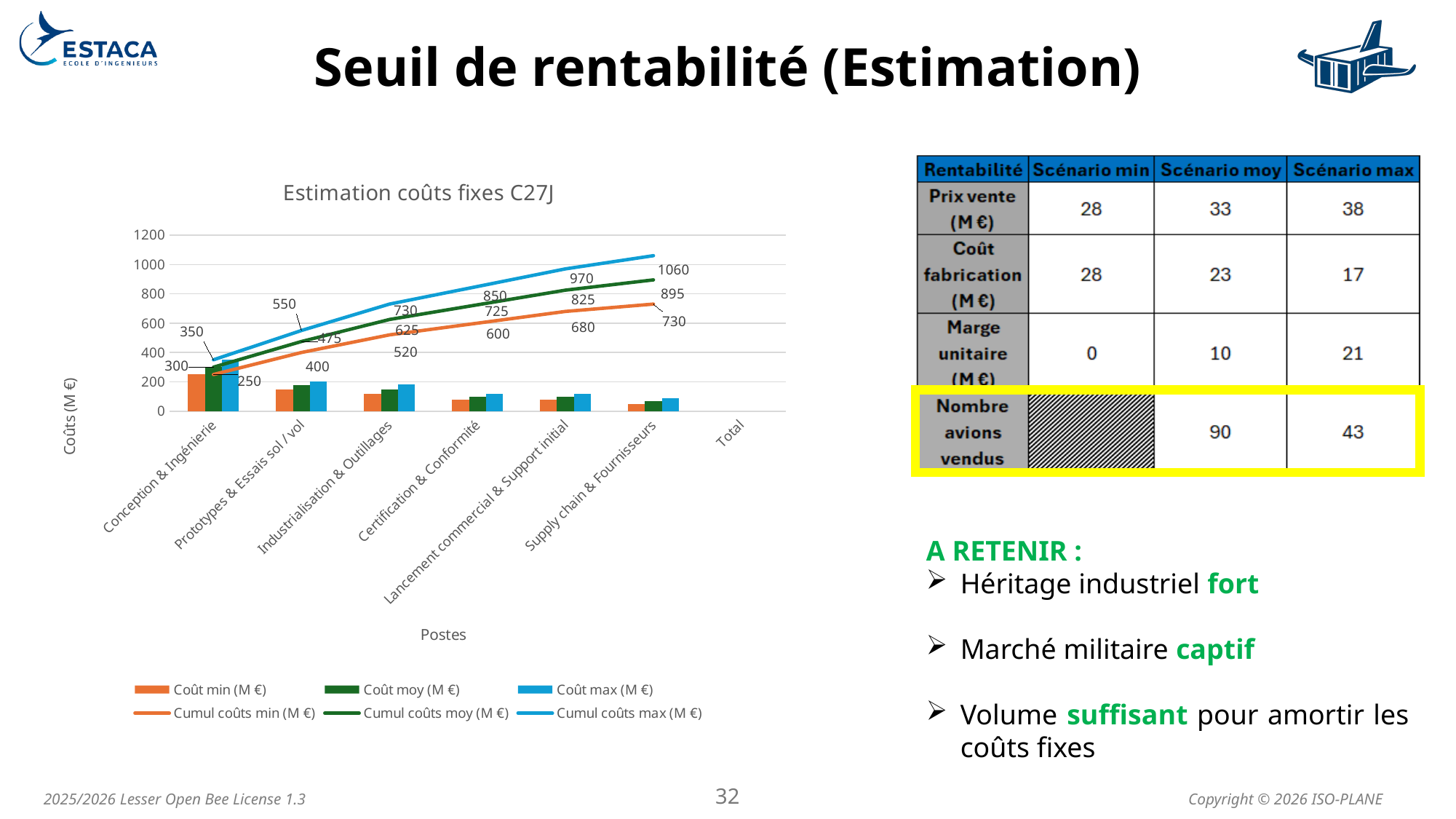
In the chart 'Estimation coûts fixes C27J', is the Coût max (M €) bar for Conception & Ingénierie greater or less than 200? greater In the chart 'Estimation coûts fixes C27J', does the Cumul coûts max (M €) line rise or fall from Conception & Ingénierie to Supply chain & Fournisseurs? rise In the chart 'Estimation coûts fixes C27J', at which category does the Cumul coûts moy (M €) line reach its highest labelled value? Supply chain & Fournisseurs In the chart 'Estimation coûts fixes C27J', what is the value of Cumul coûts min (M €) at Certification & Conformité? 600 In the chart 'Estimation coûts fixes C27J', what is the value of Cumul coûts moy (M €) at Prototypes & Essais sol / vol? 475 How many categories are shown on the x axis of the chart 'Estimation coûts fixes C27J'? 7 In the chart 'Estimation coûts fixes C27J', is the Coût min (M €) bar for Supply chain & Fournisseurs greater or less than 100? less How many series does the legend of the chart 'Estimation coûts fixes C27J' list? 6 In the chart 'Estimation coûts fixes C27J', what is the difference between Cumul coûts max and Cumul coûts min at Supply chain & Fournisseurs? 330 In the chart 'Estimation coûts fixes C27J', which is larger: Cumul coûts max at Conception & Ingénierie or Cumul coûts min at Prototypes & Essais sol / vol? Cumul coûts min at Prototypes & Essais sol / vol In the chart 'Estimation coûts fixes C27J', what is the value of Cumul coûts max (M €) at Supply chain & Fournisseurs? 1060 What kind of chart is 'Estimation coûts fixes C27J'? A combined bar and line chart